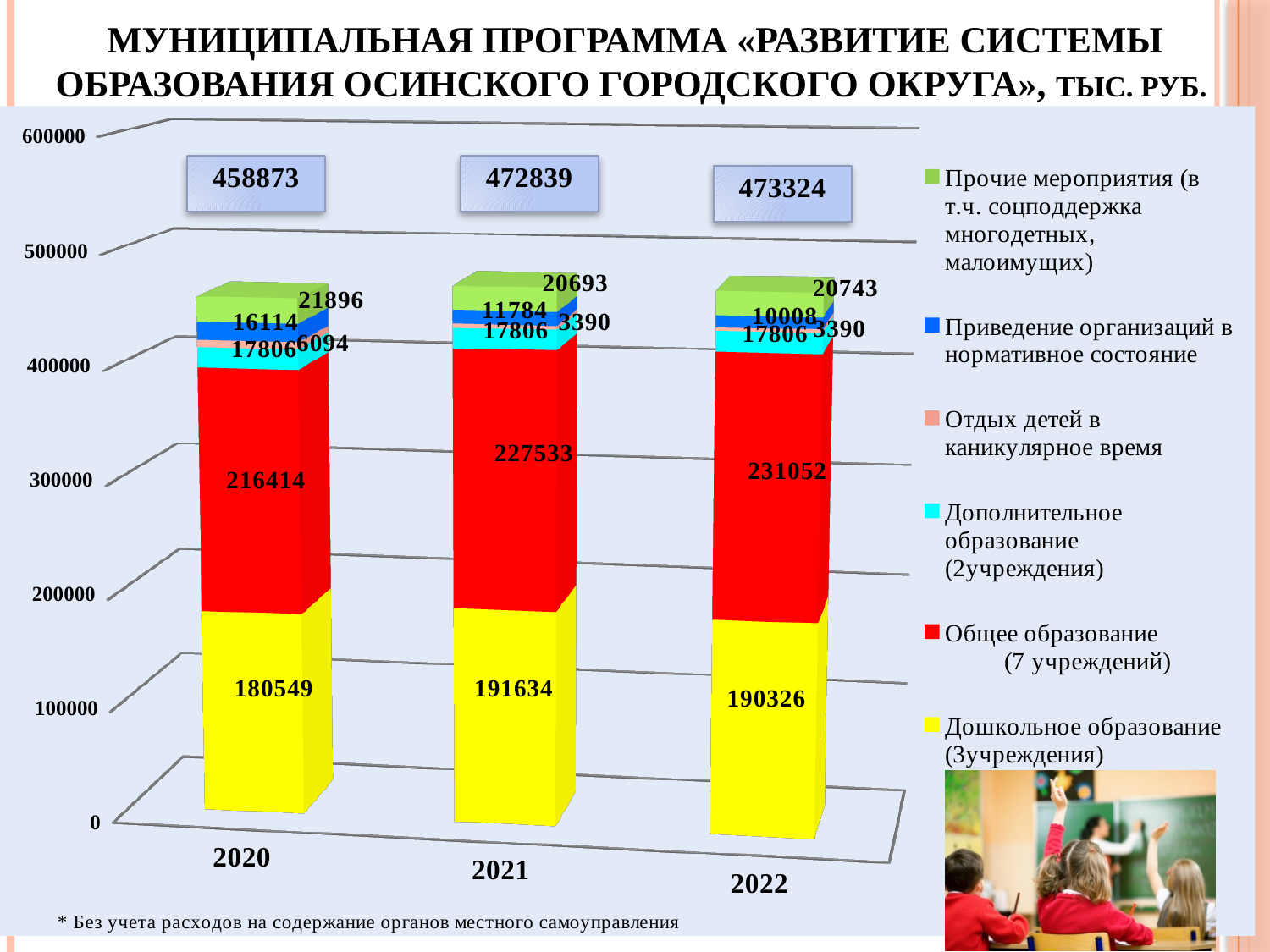
What is the value for Дошкольное образование (3учреждения) in 2020? 180549 Which is larger: the Прочие мероприятия value in 2020 or in 2021? 2020 What is the difference between the Дошкольное образование values for 2021 and 2020? 11085 What kind of chart is shown on the slide? Stacked bar chart What is the value for Отдых детей в каникулярное время in 2020? 6094 In which year is the value for Приведение организаций в нормативное состояние the lowest? 2022 How many years are shown on the x axis? 3 What is the value for Общее образование (7 учреждений) in 2022? 231052 What is the value for Приведение организаций в нормативное состояние in 2021? 11784 How many series does the legend list? 6 What is the total of the stacked bar for 2021? 472839 In which year is the value for Общее образование (7 учреждений) the highest? 2022